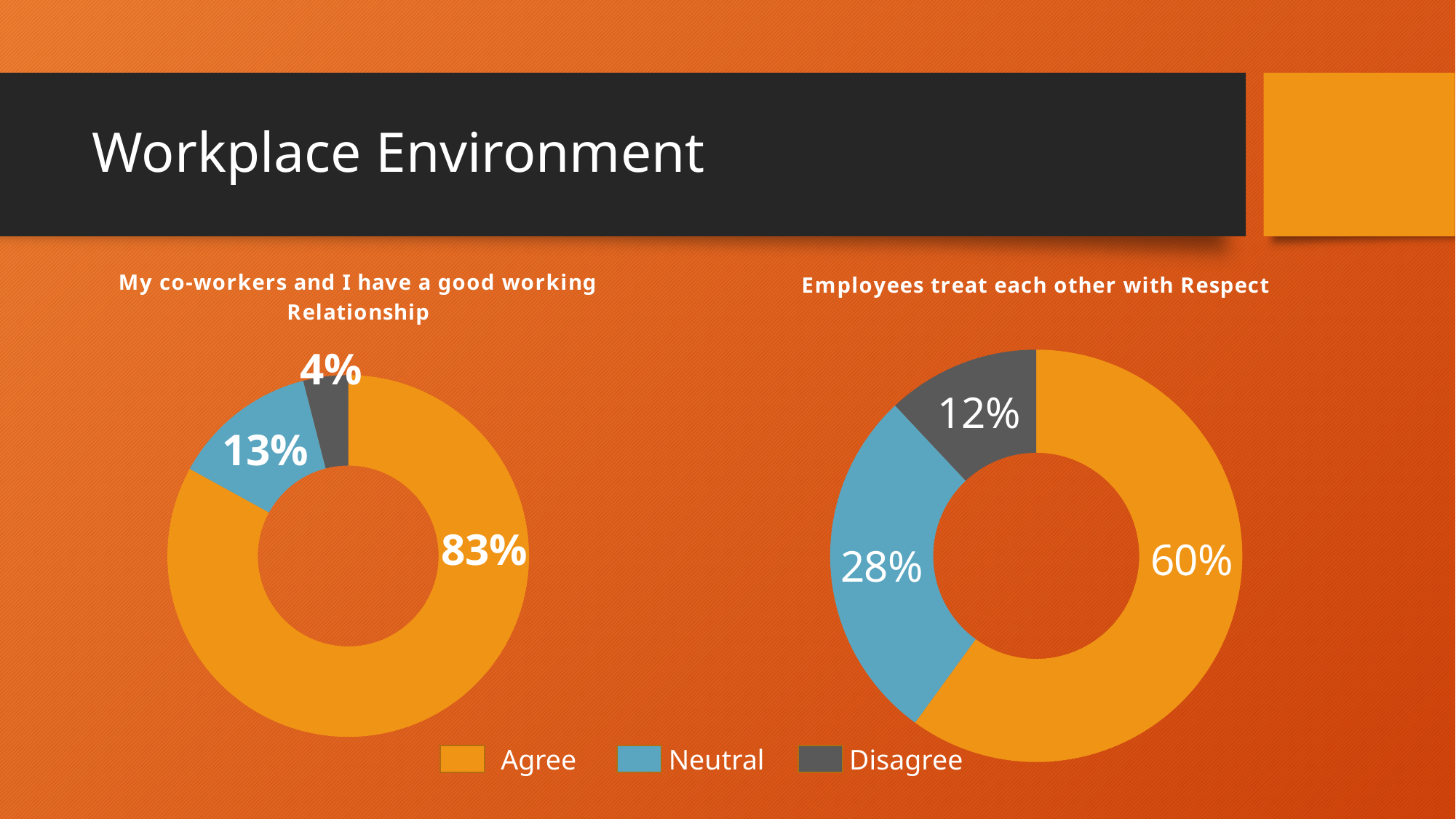
In the 'Employees treat each other with Respect' chart, what percentage is Disagree? 12% What type of chart is used for 'Employees treat each other with Respect'? Doughnut chart In the 'My co-workers and I have a good working Relationship' chart, what percentage is Disagree? 4% What is the difference between the Agree percentages in the 'My co-workers and I have a good working Relationship' chart and the 'Employees treat each other with Respect' chart? 23% How many response categories does the legend list? 3 In the 'Employees treat each other with Respect' chart, which response has the smallest share? Disagree In the 'My co-workers and I have a good working Relationship' chart, what percentage is Agree? 83% In the 'My co-workers and I have a good working Relationship' chart, which response has the largest share? Agree In the 'My co-workers and I have a good working Relationship' chart, what percentage is Neutral? 13% In the 'Employees treat each other with Respect' chart, what percentage is Agree? 60% In the 'Employees treat each other with Respect' chart, what percentage is Neutral? 28% Which chart has the larger Neutral share, 'My co-workers and I have a good working Relationship' or 'Employees treat each other with Respect'? Employees treat each other with Respect